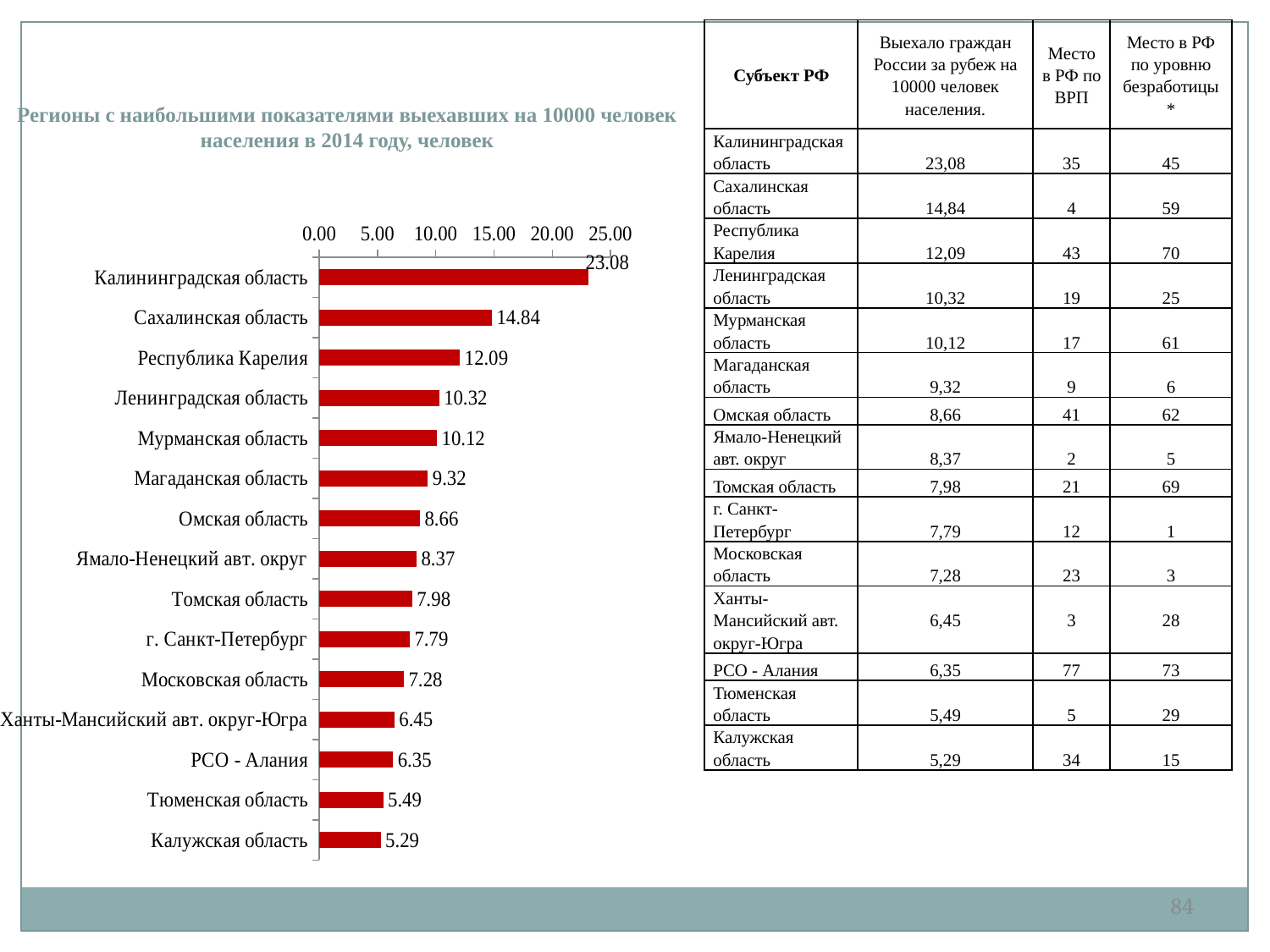
What is the value for Ханты-Мансийский авт. округ-Югра in the chart? 6.45 Do the bar values increase or decrease going from the top of the chart to the bottom? decrease What type of chart is shown on the slide? bar chart How many regions are plotted in the chart? 15 What is the title of the chart? Регионы с наибольшими показателями выехавших на 10000 человек населения в 2014 году, человек What is the value for Калининградская область in the chart? 23.08 Which region has the highest value in the chart? Калининградская область Is the value for Сахалинская область greater or less than 10.00? greater Which region has the lowest value in the chart? Калужская область What is the difference between the values for Калининградская область and Сахалинская область? 8.24 Which has a larger value, Ленинградская область or Мурманская область? Ленинградская область What is the value for Республика Карелия in the chart? 12.09